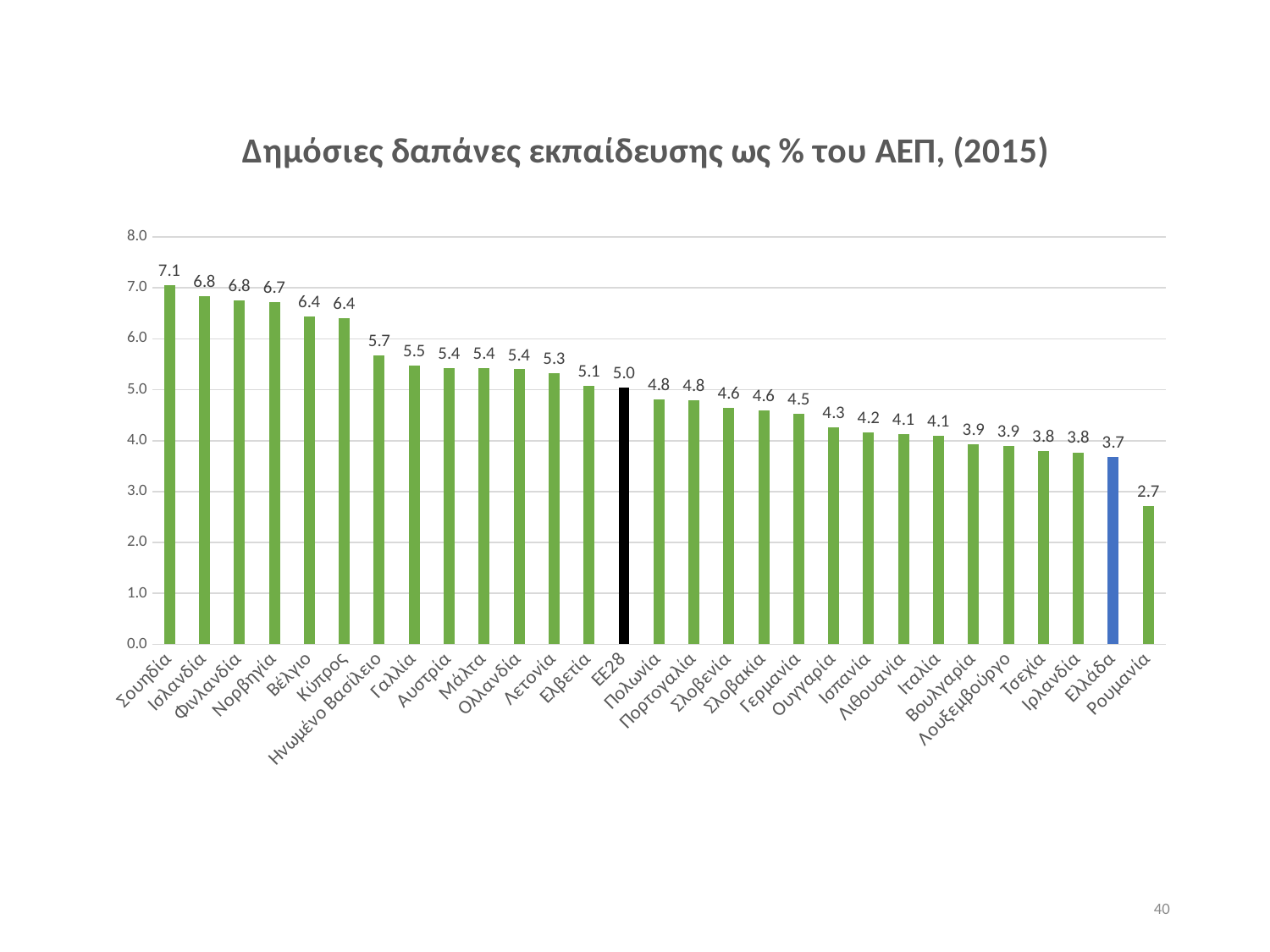
Which country has the lowest value? Ρουμανία What is the title of the chart? Δημόσιες δαπάνες εκπαίδευσης ως % του ΑΕΠ, (2015) What is the value for Ηνωμένο Βασίλειο? 5.7 How many bars are shown in the chart? 29 What is the difference between the values for ΕΕ28 and Ελλάδα? 1.3 Do the values rise or fall from left to right along the x axis? fall What is the value for ΕΕ28? 5.0 Which country has the highest value? Σουηδία What kind of chart is shown on the slide? bar chart What is the value for Ελλάδα? 3.7 Which has a larger value, Γαλλία or Γερμανία? Γαλλία What is the difference between the values for Σουηδία and Ρουμανία? 4.4